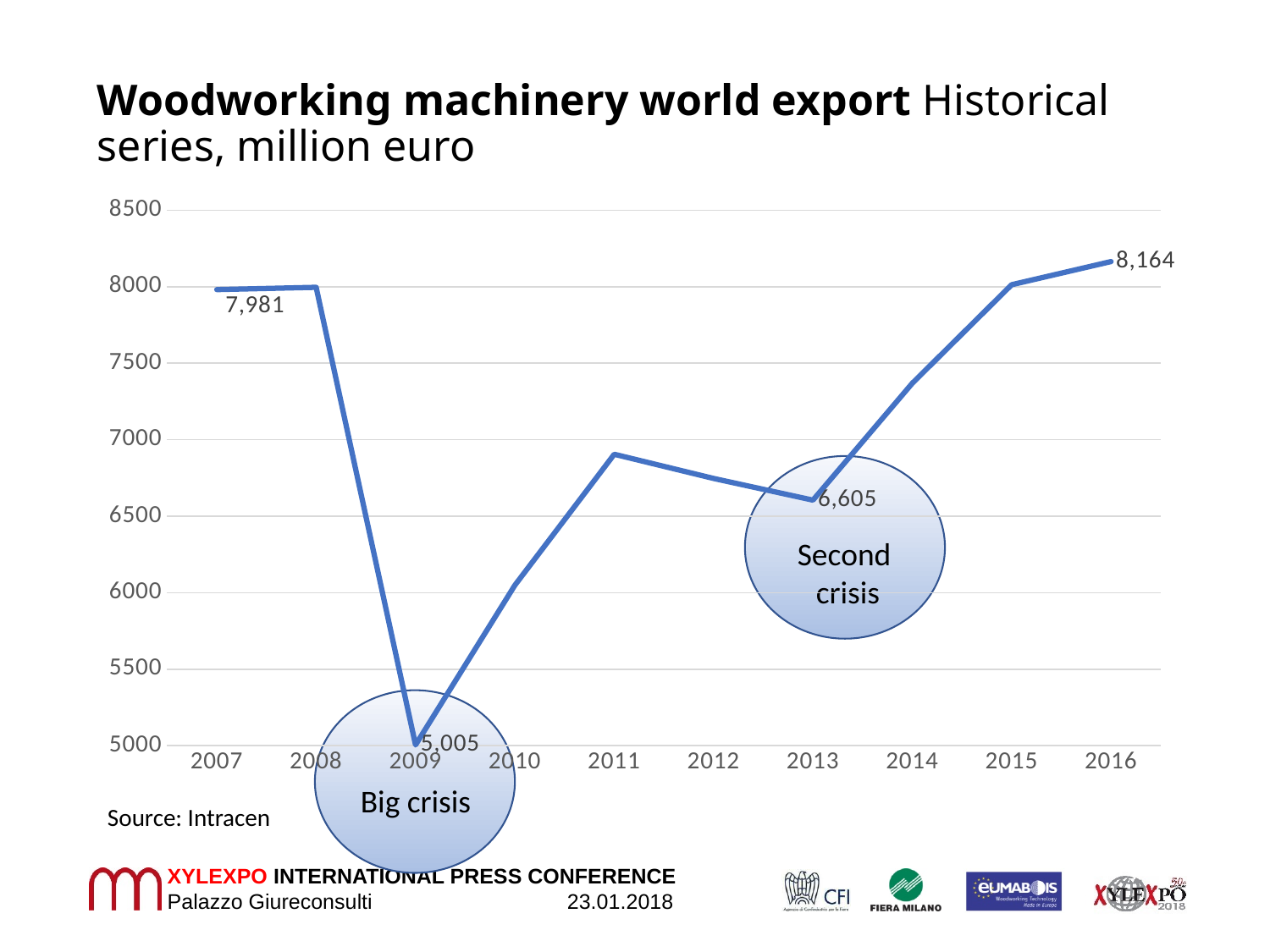
What is the value for 2016? 8,164 What kind of chart is shown? line chart How many years are plotted on the x axis? 10 Which is larger, the value for 2007 or the value for 2016? 2016 Is the value for 2011 greater or less than 6500? greater What is the difference between the values for 2016 and 2007? 183 Which year has the highest value? 2016 Which year has the lowest value? 2009 Which year is annotated with the label "Big crisis"? 2009 What is the value for 2013? 6,605 What is the value for 2007? 7,981 What is the value for 2009? 5,005